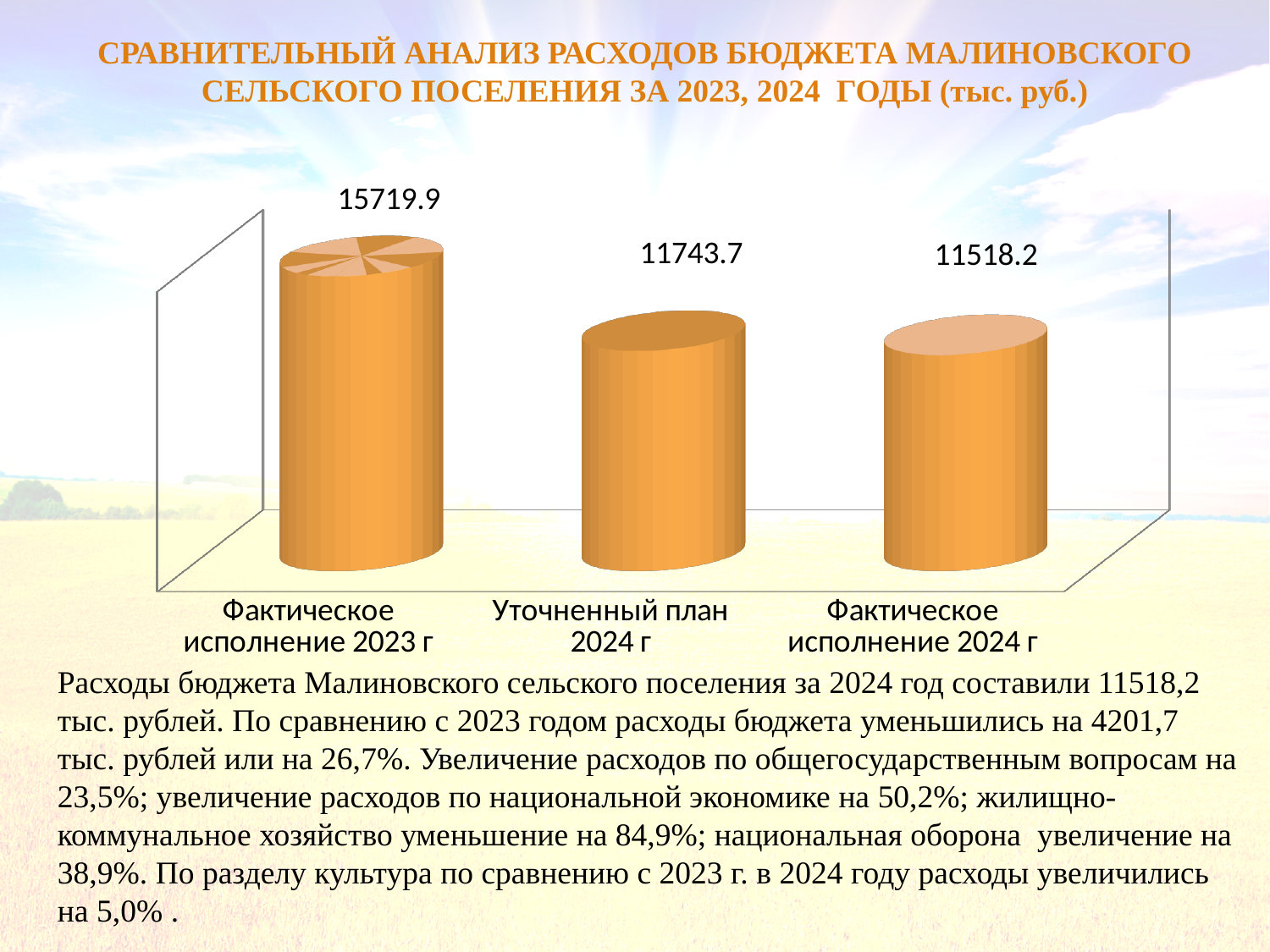
How many categories are shown in the chart? 3 What is the value for Фактическое исполнение 2023 г? 15719.9 What is the value for Фактическое исполнение 2024 г? 11518.2 Which category has the lowest value? Фактическое исполнение 2024 г What is the value for Уточненный план 2024 г? 11743.7 What is the difference between Фактическое исполнение 2023 г and Фактическое исполнение 2024 г? 4201.7 What kind of chart is shown on the slide? Bar chart Do the values rise or fall from left to right across the categories? Fall What is the difference between Уточненный план 2024 г and Фактическое исполнение 2024 г? 225.5 Which category has the highest value? Фактическое исполнение 2023 г What colour are the bars in the chart? Orange Which is larger: Фактическое исполнение 2023 г or Уточненный план 2024 г? Фактическое исполнение 2023 г